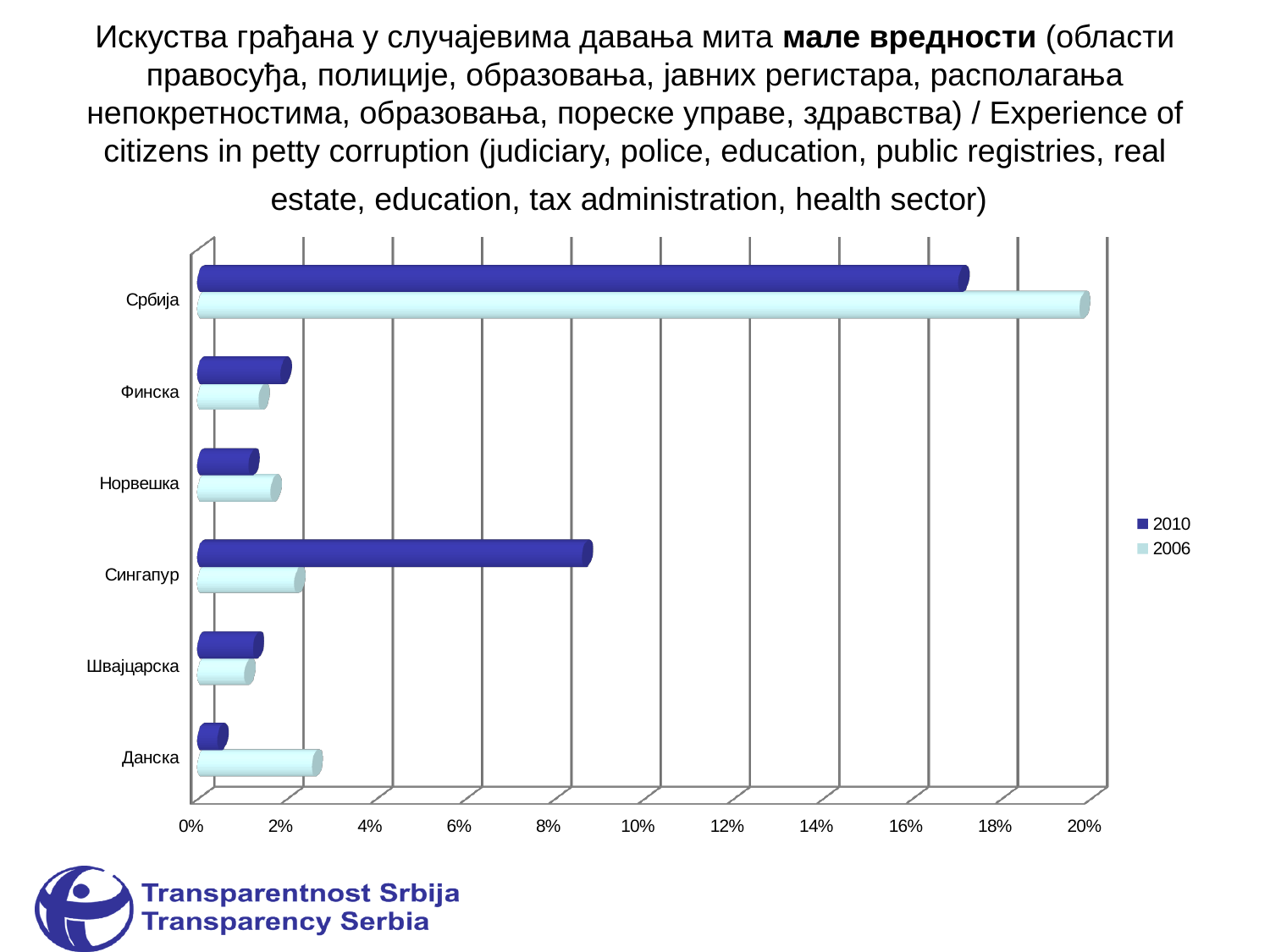
Is the 2010 value for Сингапур greater or less than 8%? greater Which country has the highest value for 2010? Србија For Сингапур, which year has the larger value, 2010 or 2006? 2010 How many countries are shown on the chart? 6 Which country has the highest value for 2006? Србија What kind of chart is shown on the slide? bar chart What are the two entries listed in the legend? 2010 and 2006 For Данска, which year has the larger value, 2010 or 2006? 2006 Which country has the lowest value for 2010? Данска How many series does the legend list? 2 Is the 2010 value for Србија greater or less than 16%? greater For Србија, which year has the larger value, 2010 or 2006? 2006